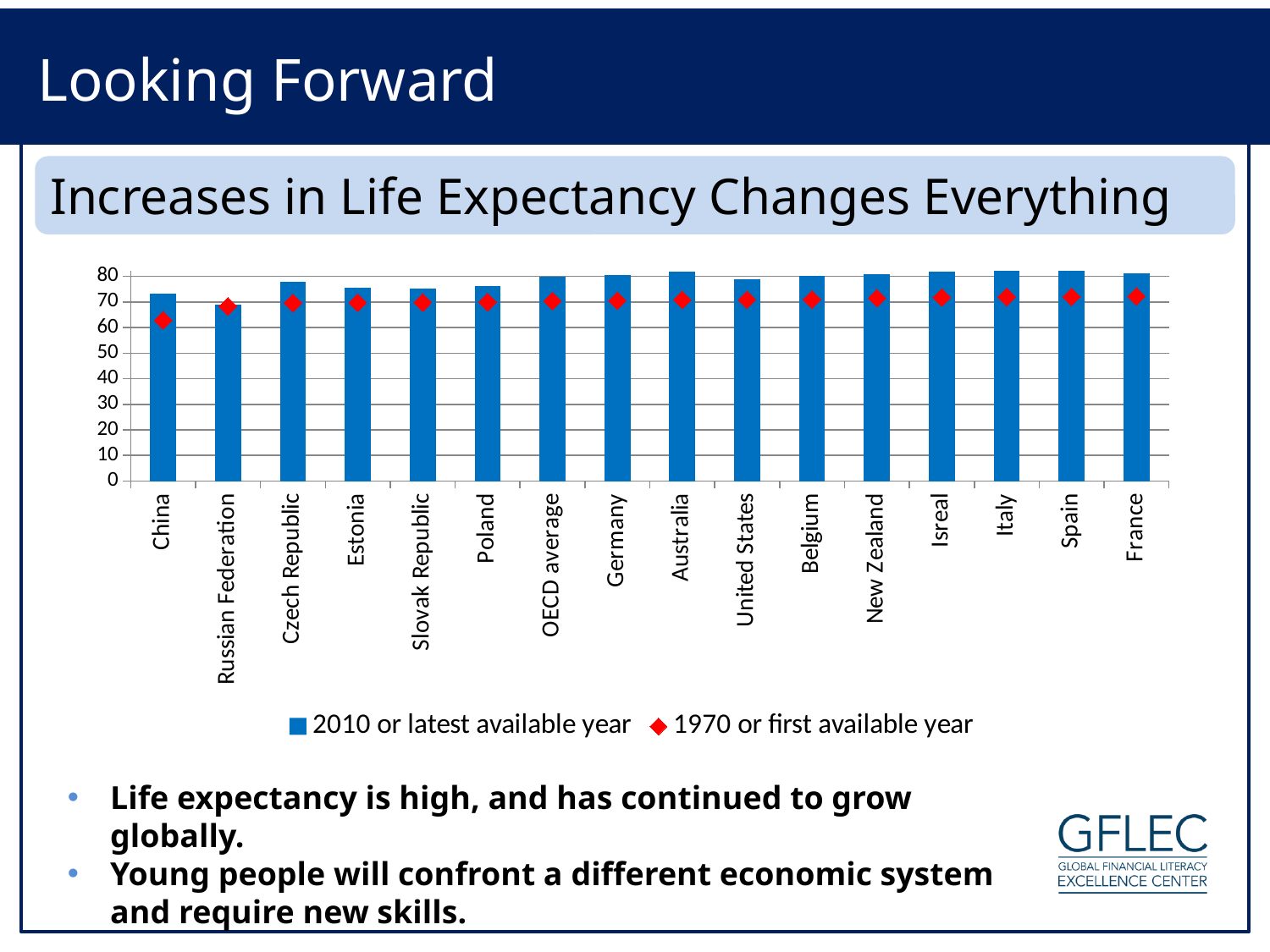
What kind of chart is shown on the slide? Bar chart Is the 1970 or first available year value for China greater or less than 60? greater How many series does the chart's legend list? 2 Which has the larger 1970 or first available year value, China or Italy? Italy Which has the larger 2010 or latest available year value, China or France? France How many countries or categories are shown along the x axis of the chart? 16 What are the two series named in the chart's legend? 2010 or latest available year; 1970 or first available year Do the 1970 or first available year values generally rise or fall moving from left to right along the x axis? Rise Which category has the lowest bar for 2010 or latest available year? Russian Federation Is the 2010 or latest available year value for China greater or less than 70? greater